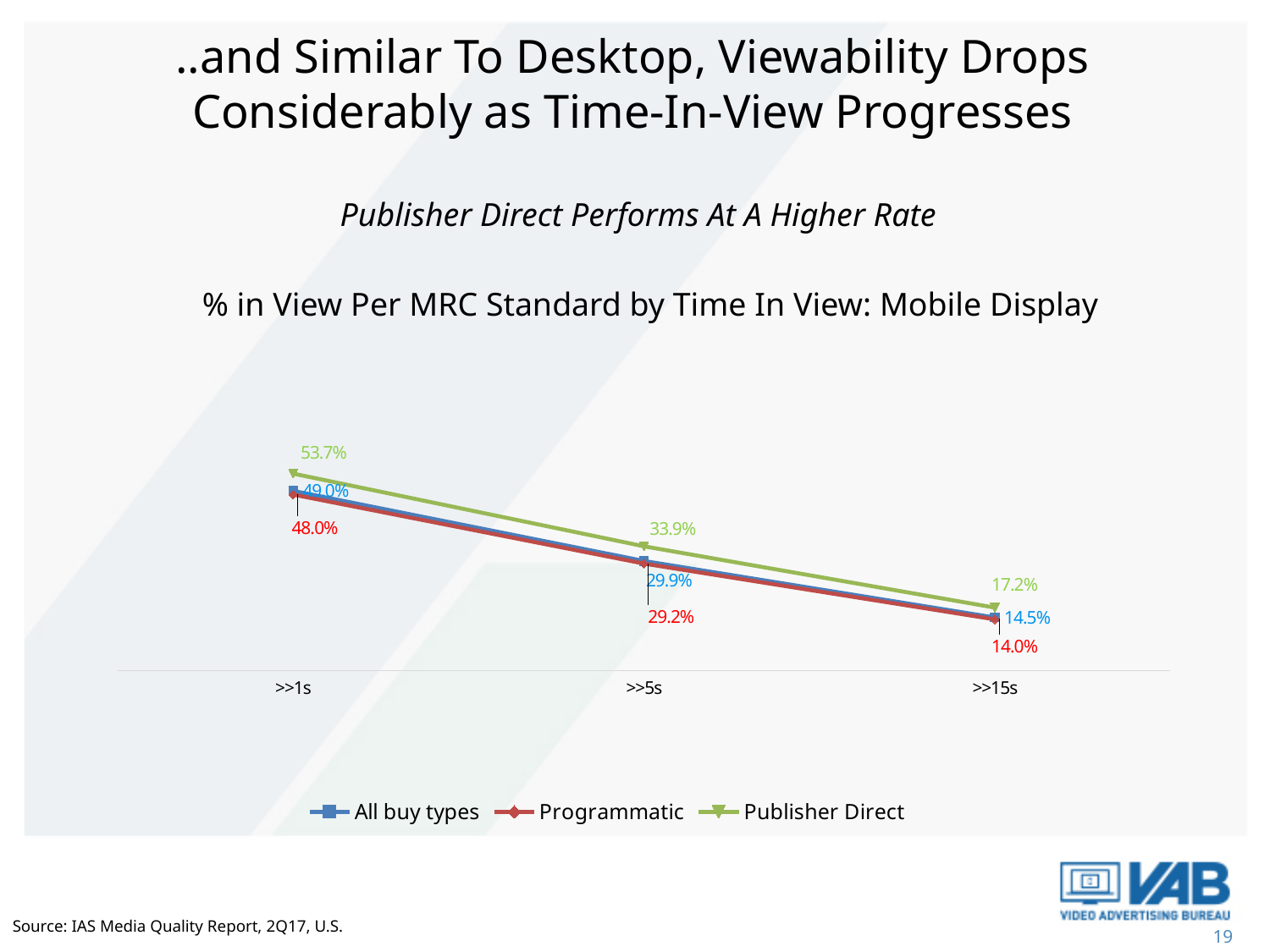
What type of chart is shown on the slide? line chart What is the difference between Publisher Direct and Programmatic at >>5s? 4.7% What is the value for Programmatic at >>5s? 29.2% Do the values for Publisher Direct rise or fall as time in view progresses from >>1s to >>15s? fall What is the value for Publisher Direct at >>1s? 53.7% What is the title of the chart? % in View Per MRC Standard by Time In View: Mobile Display Which is larger at >>1s: Publisher Direct or All buy types? Publisher Direct How many series does the legend list? 3 What is the value for All buy types at >>15s? 14.5% How many time-in-view categories are shown on the x axis? 3 Which series has the highest value at >>15s? Publisher Direct Which series has the lowest value at >>1s? Programmatic